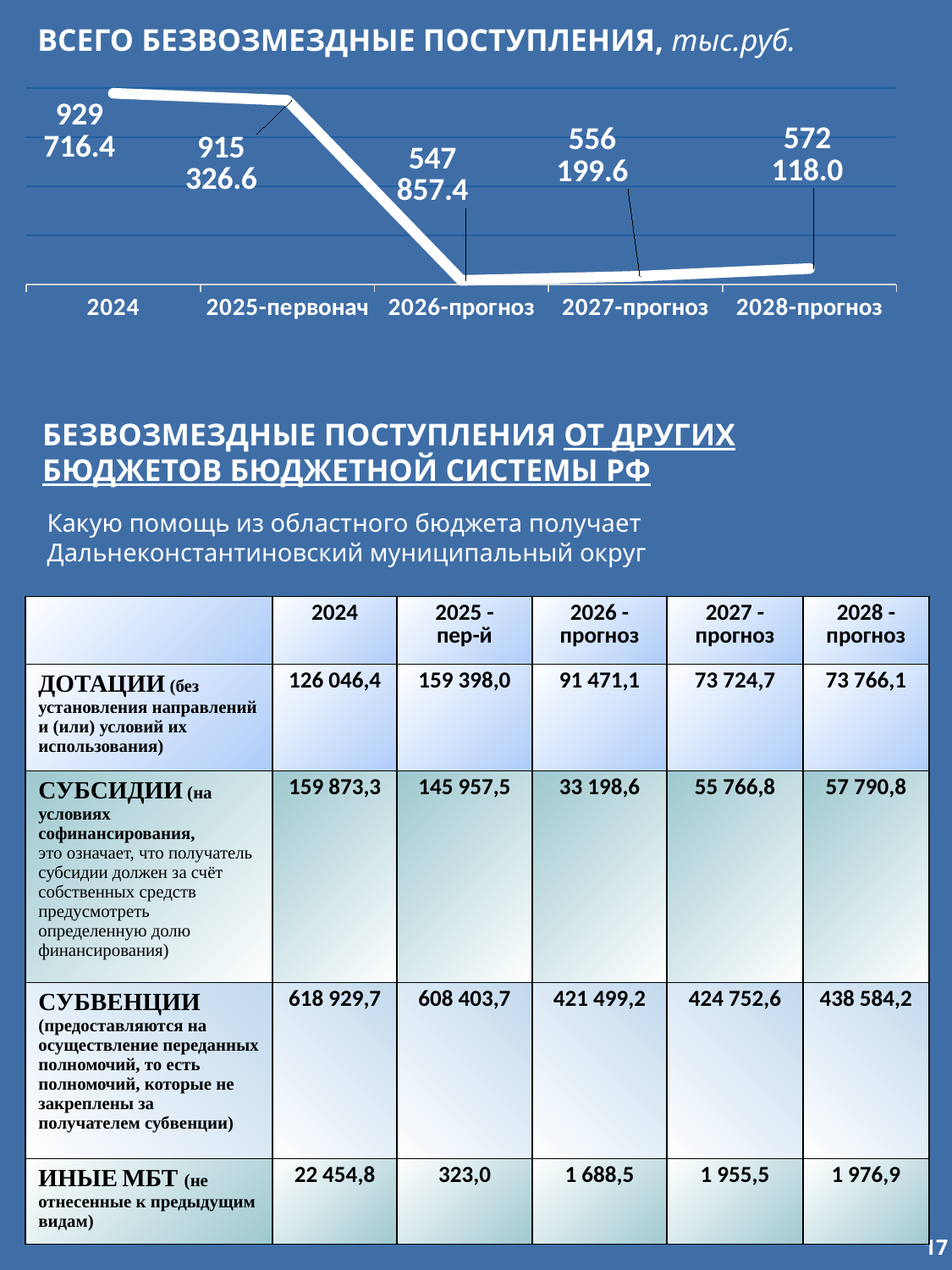
In the chart "ВСЕГО БЕЗВОЗМЕЗДНЫЕ ПОСТУПЛЕНИЯ", which is larger: the value for 2027-прогноз or the value for 2028-прогноз? 2028-прогноз In the chart "ВСЕГО БЕЗВОЗМЕЗДНЫЕ ПОСТУПЛЕНИЯ", what is the value for 2025-первонач? 915 326.6 In the chart "ВСЕГО БЕЗВОЗМЕЗДНЫЕ ПОСТУПЛЕНИЯ", how many data points are plotted? 5 In the chart "ВСЕГО БЕЗВОЗМЕЗДНЫЕ ПОСТУПЛЕНИЯ", what is the value for 2026-прогноз? 547 857.4 In the chart "ВСЕГО БЕЗВОЗМЕЗДНЫЕ ПОСТУПЛЕНИЯ", does the value rise or fall from 2025-первонач to 2026-прогноз? fall What type of chart is shown under the title "ВСЕГО БЕЗВОЗМЕЗДНЫЕ ПОСТУПЛЕНИЯ, тыс.руб."? line chart In the chart "ВСЕГО БЕЗВОЗМЕЗДНЫЕ ПОСТУПЛЕНИЯ", what is the value for 2024? 929 716.4 In the chart "ВСЕГО БЕЗВОЗМЕЗДНЫЕ ПОСТУПЛЕНИЯ", which category has the lowest value? 2026-прогноз In the chart "ВСЕГО БЕЗВОЗМЕЗДНЫЕ ПОСТУПЛЕНИЯ", what is the value for 2028-прогноз? 572 118.0 In the chart "ВСЕГО БЕЗВОЗМЕЗДНЫЕ ПОСТУПЛЕНИЯ", what is the difference between the values for 2024 and 2025-первонач? 14 389.8 In the chart "ВСЕГО БЕЗВОЗМЕЗДНЫЕ ПОСТУПЛЕНИЯ", which category has the highest value? 2024 In the chart "ВСЕГО БЕЗВОЗМЕЗДНЫЕ ПОСТУПЛЕНИЯ", what is the difference between the values for 2028-прогноз and 2026-прогноз? 24 260.6